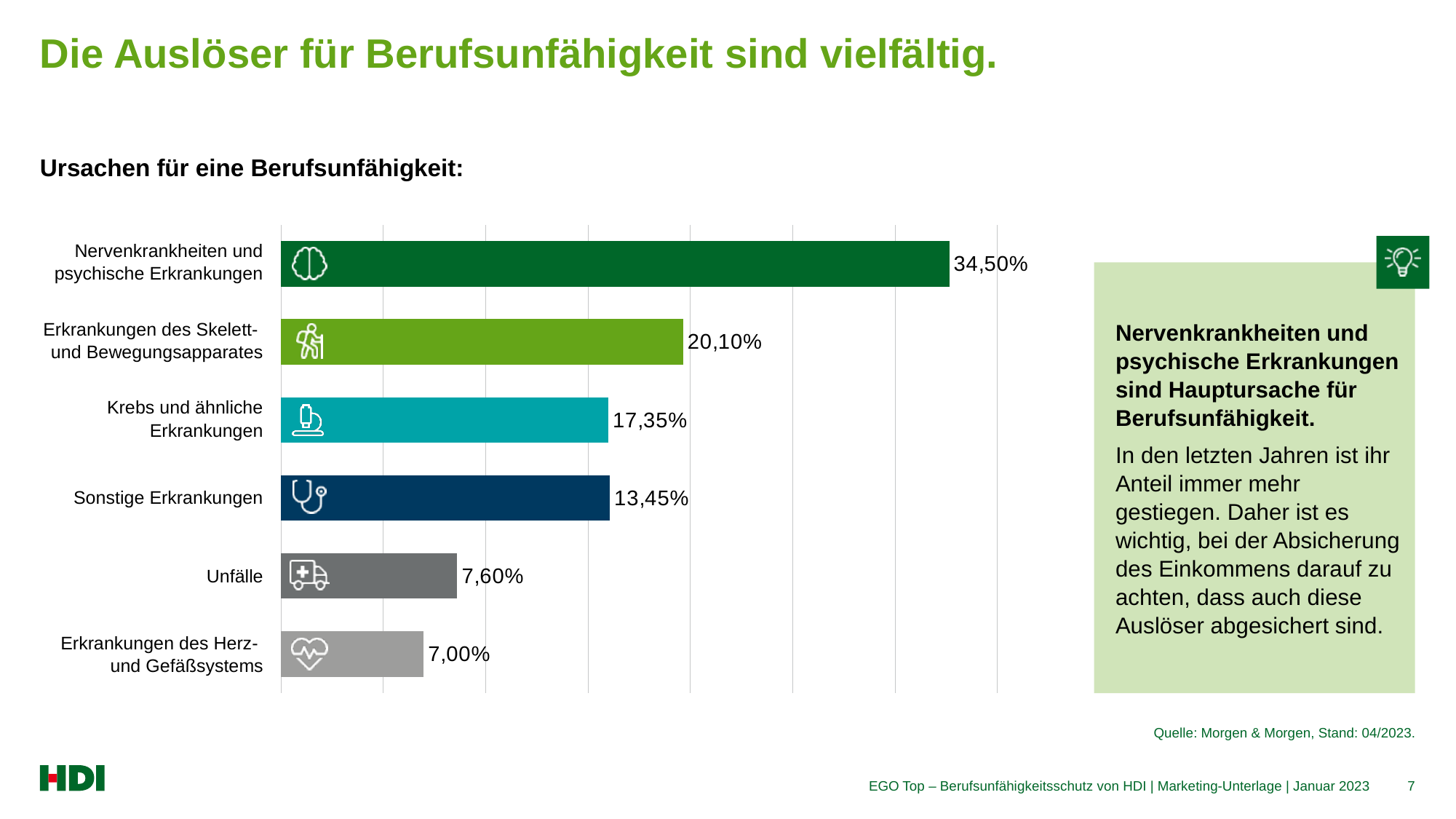
What kind of chart is shown on the slide? Bar chart What is the value for Nervenkrankheiten und psychische Erkrankungen? 34,50% Which is larger, the value for Unfälle or the value for Erkrankungen des Herz- und Gefäßsystems? Unfälle What is the difference between the values for Krebs und ähnliche Erkrankungen and Sonstige Erkrankungen? 3,90% What is the value for Erkrankungen des Skelett- und Bewegungsapparates? 20,10% What is the value for Krebs und ähnliche Erkrankungen? 17,35% How many categories are shown in the chart? 6 What is the value for Unfälle? 7,60% Which category has the lowest value? Erkrankungen des Herz- und Gefäßsystems What is the difference between the values for Nervenkrankheiten und psychische Erkrankungen and Erkrankungen des Skelett- und Bewegungsapparates? 14,40% What is the heading above the chart? Ursachen für eine Berufsunfähigkeit: Which category has the highest value? Nervenkrankheiten und psychische Erkrankungen